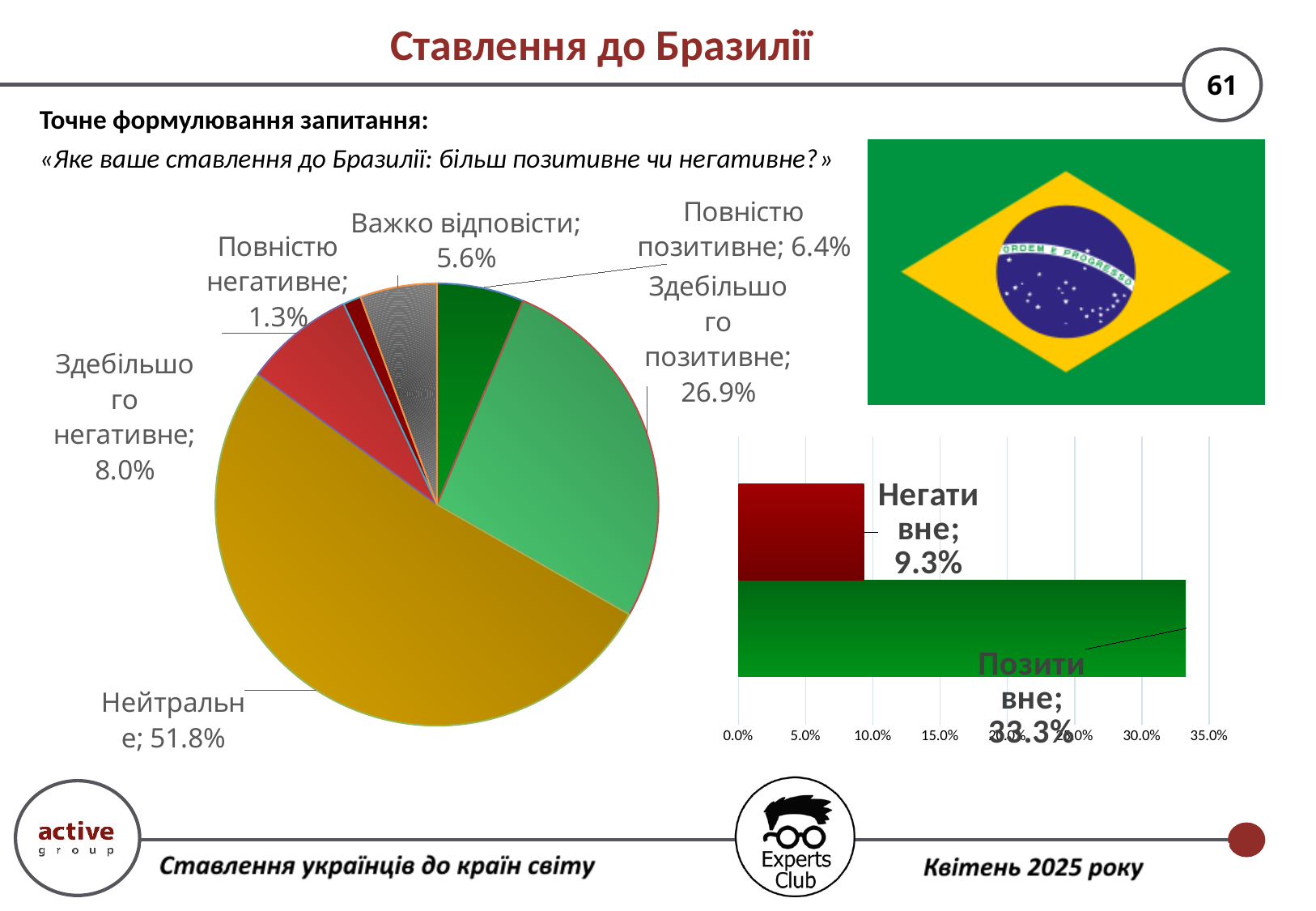
What type of chart is shown on the right side of the slide? Bar chart In the pie chart, what share is labelled for "Нейтральне"? 51.8% In the pie chart, which category has the smallest slice? Повністю негативне In the bar chart on the right, what is the difference between "Позитивне" and "Негативне"? 24.0% How many slices does the pie chart have? 6 In the pie chart, what is the value for "Повністю негативне"? 1.3% In the bar chart on the right, what is the value for "Позитивне"? 33.3% In the pie chart, which category has the largest slice? Нейтральне In the pie chart, which is larger: "Важко відповісти" or "Повністю позитивне"? Повністю позитивне In the bar chart on the right, what is the value for "Негативне"? 9.3% In the pie chart, what is the difference between "Здебільшого позитивне" and "Здебільшого негативне"? 18.9% In the pie chart, what is the value for "Здебільшого позитивне"? 26.9%